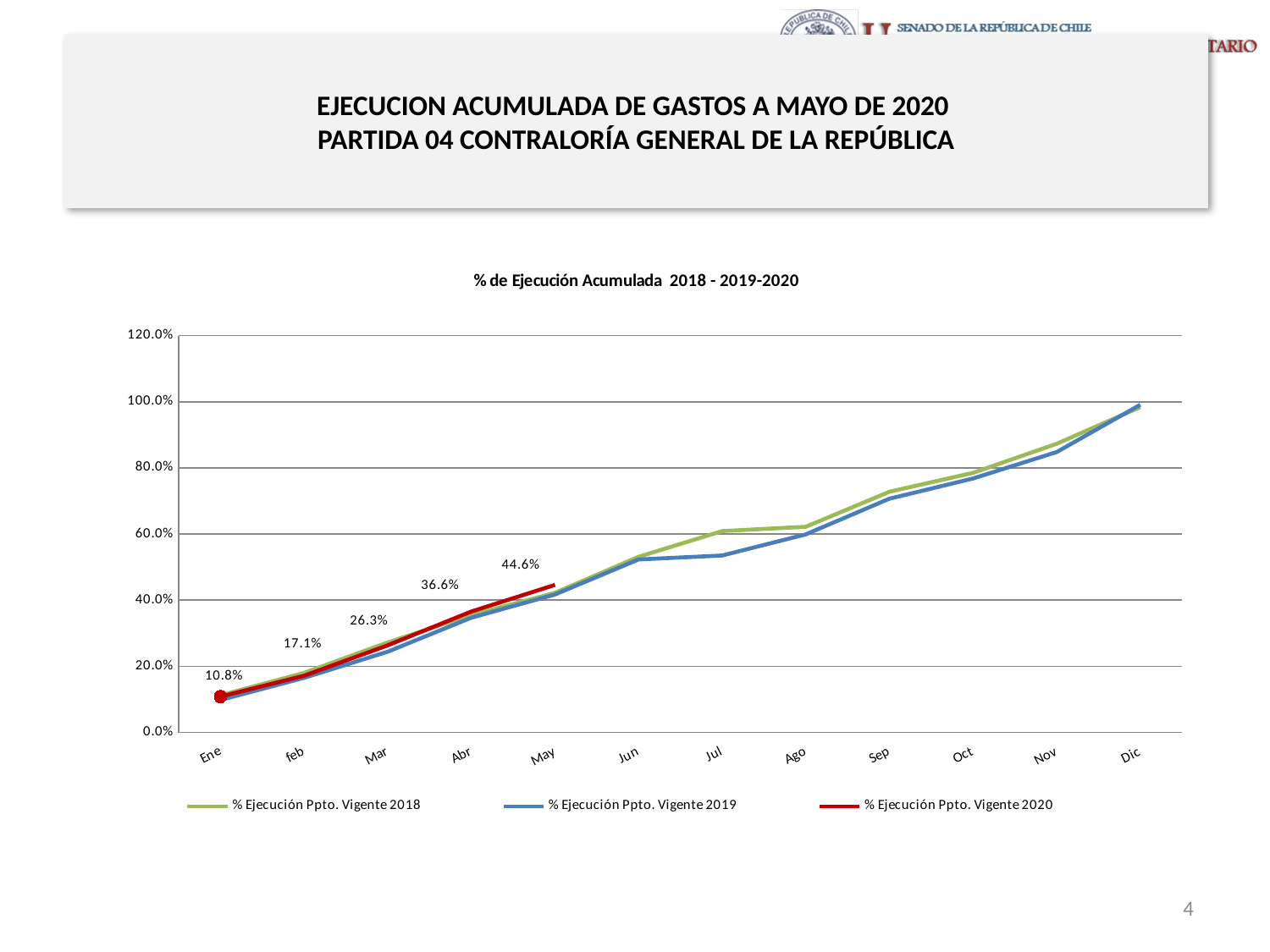
How many months are shown on the x axis? 12 What is the value of % Ejecución Ppto. Vigente 2020 for Mar? 26.3% What is the value of % Ejecución Ppto. Vigente 2020 for May? 44.6% What type of chart is shown on the slide? line chart Is the value of % Ejecución Ppto. Vigente 2019 for Jul greater or less than 60.0%? less How many series does the legend list? 3 What is the value of % Ejecución Ppto. Vigente 2020 for Ene? 10.8% What is the title of the chart? % de Ejecución Acumulada 2018 - 2019-2020 Is the value of % Ejecución Ppto. Vigente 2018 for Sep greater or less than 60.0%? greater What is the difference between the % Ejecución Ppto. Vigente 2020 values for Feb and Ene? 6.3% Do the values of % Ejecución Ppto. Vigente 2020 rise or fall from Ene to May? rise What is the difference between the % Ejecución Ppto. Vigente 2020 values for Abr and Mar? 10.3%